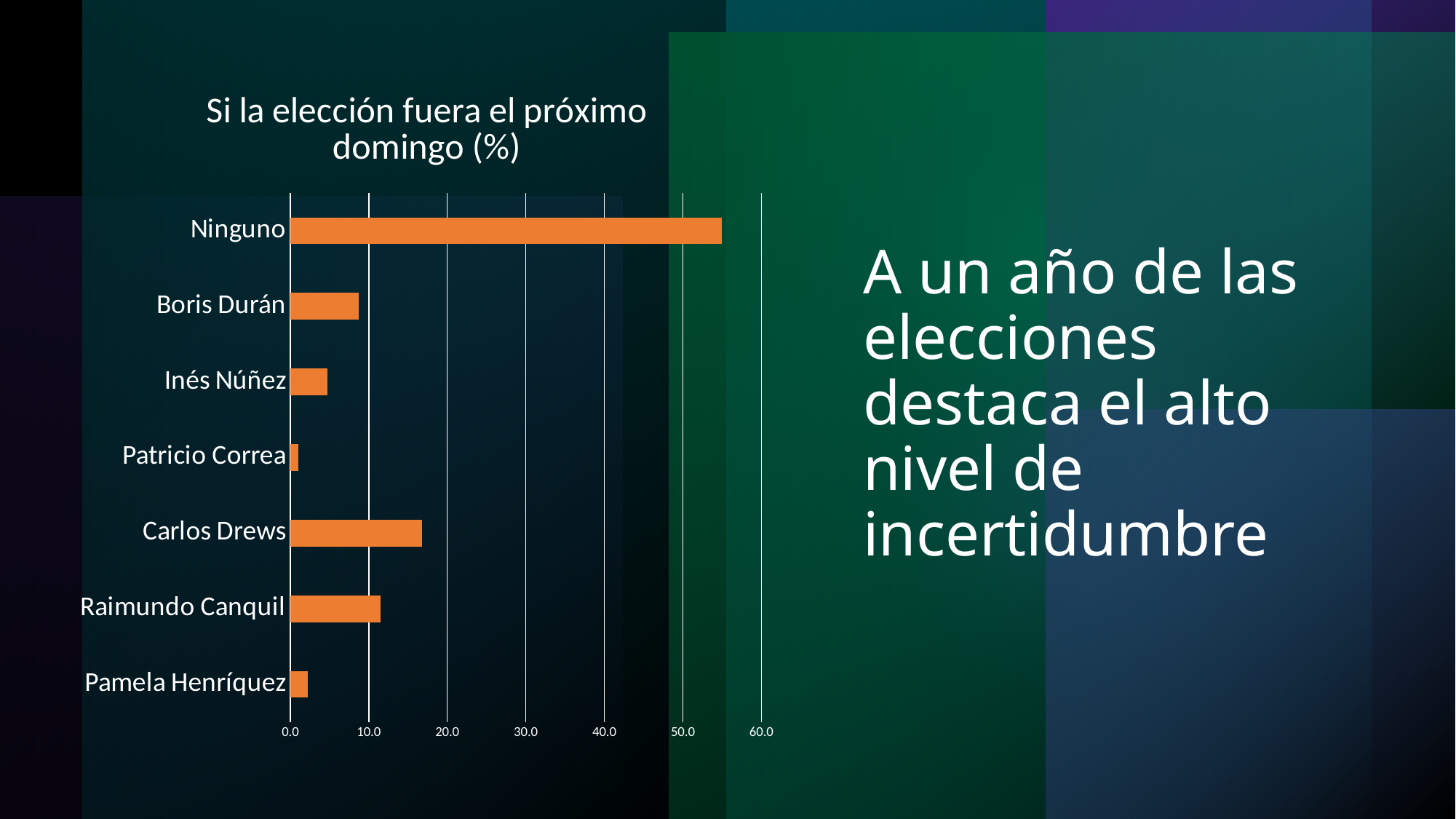
Is the value for Raimundo Canquil greater or less than 10.0? greater Is the value for Boris Durán greater or less than 10.0? less Is the value for Carlos Drews greater or less than 20.0? less Which is larger, the value for Inés Núñez or the value for Boris Durán? Boris Durán What is the highest value shown on the horizontal axis? 60.0 Which category has the lowest value? Patricio Correa What type of chart is shown on the slide? bar chart Which category has the highest value? Ninguno What is the title of the chart? Si la elección fuera el próximo domingo (%) How many categories are shown in the chart? 7 Which is larger, the value for Carlos Drews or the value for Raimundo Canquil? Carlos Drews